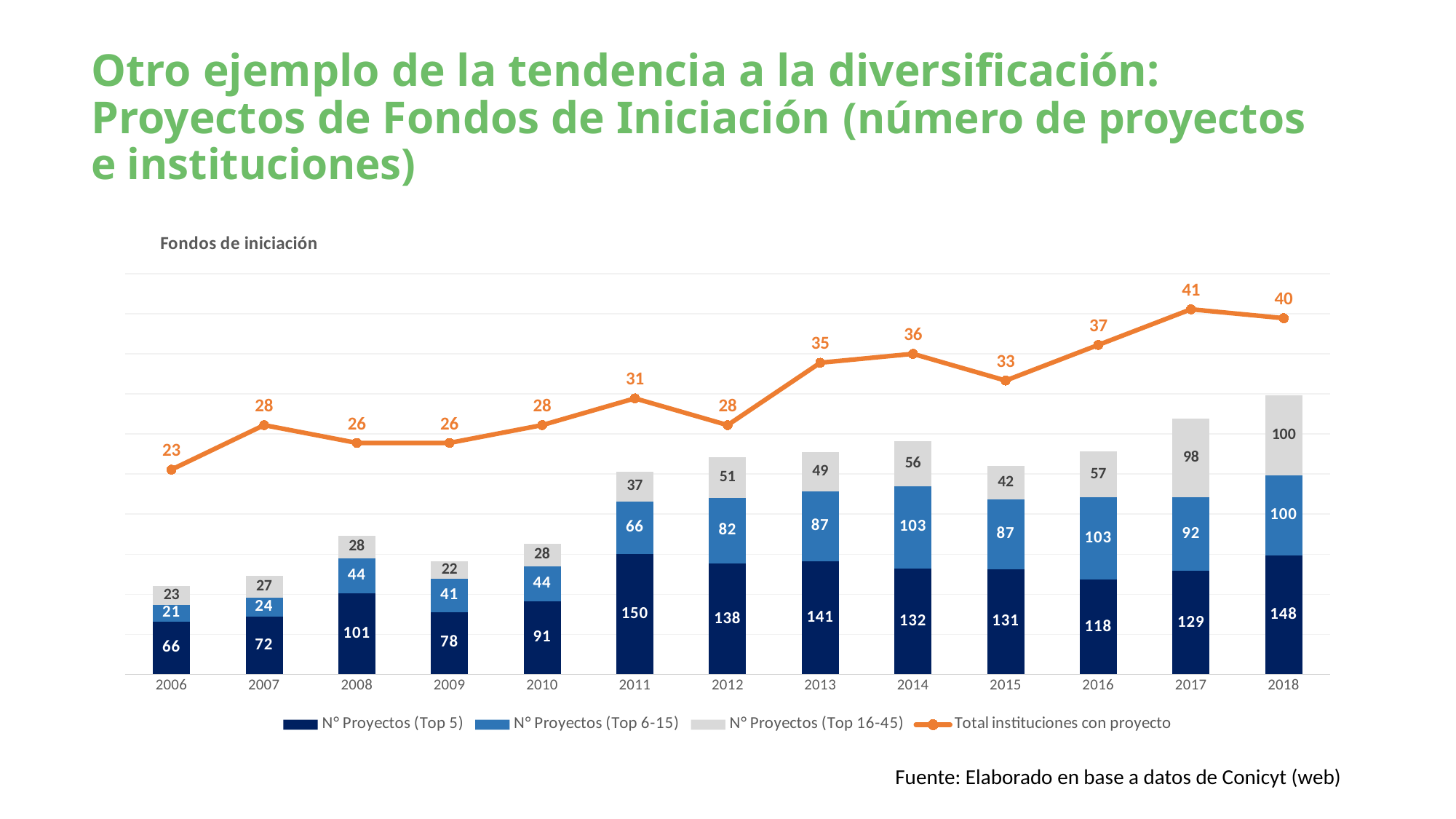
What is the value of N° Proyectos (Top 16-45) for 2018? 100 Which year has the lowest value for Total instituciones con proyecto? 2006 What kind of chart is this? Stacked bar chart with a line What is the difference between N° Proyectos (Top 6-15) in 2014 and in 2006? 82 What is the value of N° Proyectos (Top 5) for 2011? 150 Which year has the highest value for N° Proyectos (Top 5)? 2011 How many series does the legend list? 4 Which is larger: N° Proyectos (Top 16-45) in 2017 or in 2016? 2017 What is the value of Total instituciones con proyecto for 2017? 41 Does Total instituciones con proyecto generally rise or fall from 2006 to 2018? Rise How many years are shown on the x axis? 13 What is the total number of projects in the stacked bar for 2018? 348